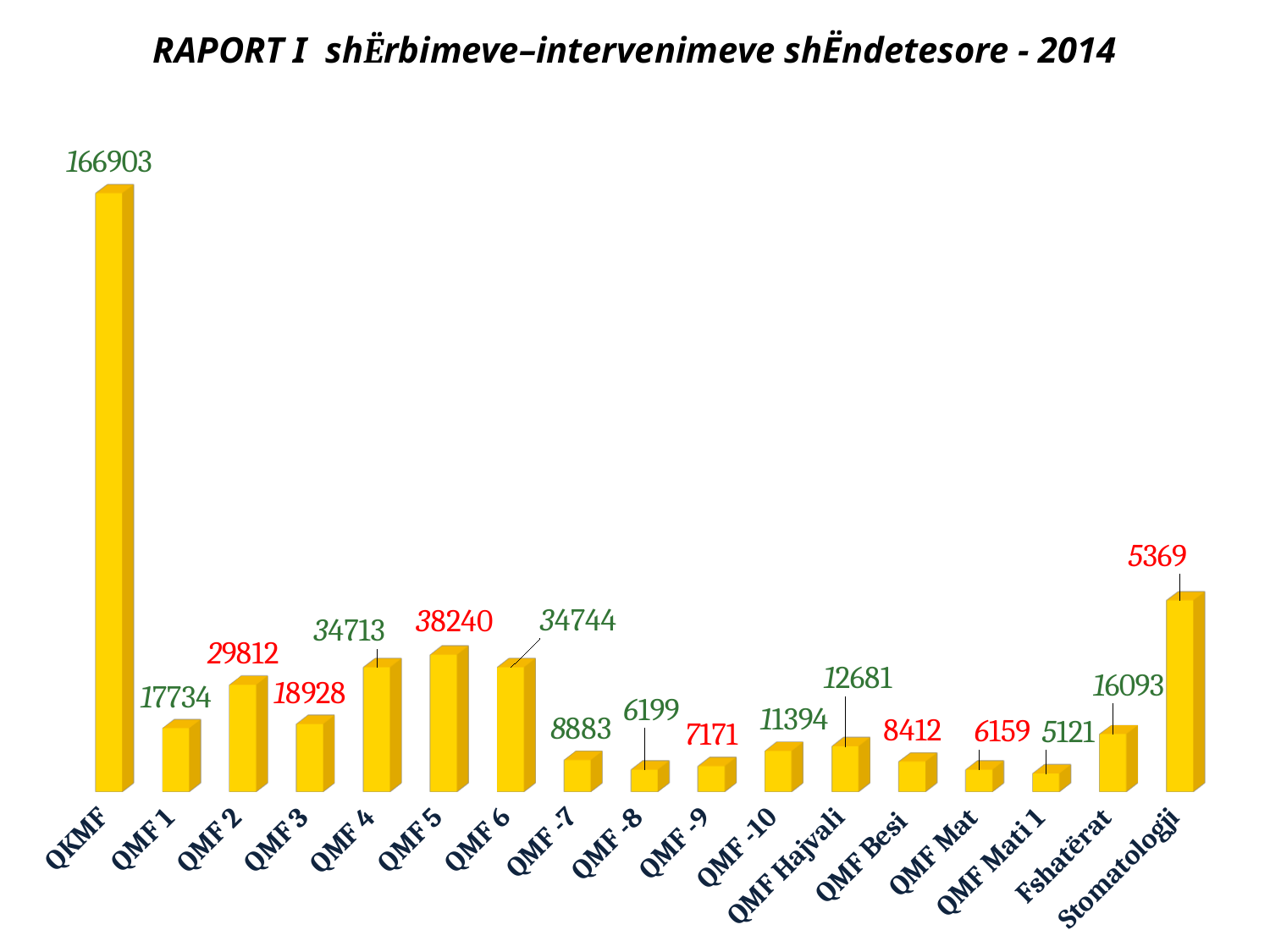
Which category has the highest value? QKMF What is the difference between the values for QMF 5 and QMF 4? 3527 How many categories are shown on the x axis? 17 What is the difference between the values for QMF 2 and QMF 1? 12078 What is the value for QMF 5? 38240 What is the value for Fshatërat? 16093 What is the value for QMF Hajvali? 12681 What is the value for QKMF? 166903 What is the value for QMF Mati 1? 5121 What is the title of the chart? RAPORT I shËrbimeve–intervenimeve shËndetesore - 2014 What kind of chart is shown on the slide? Bar chart Which is larger, the value for QMF 2 or the value for QMF 3? QMF 2